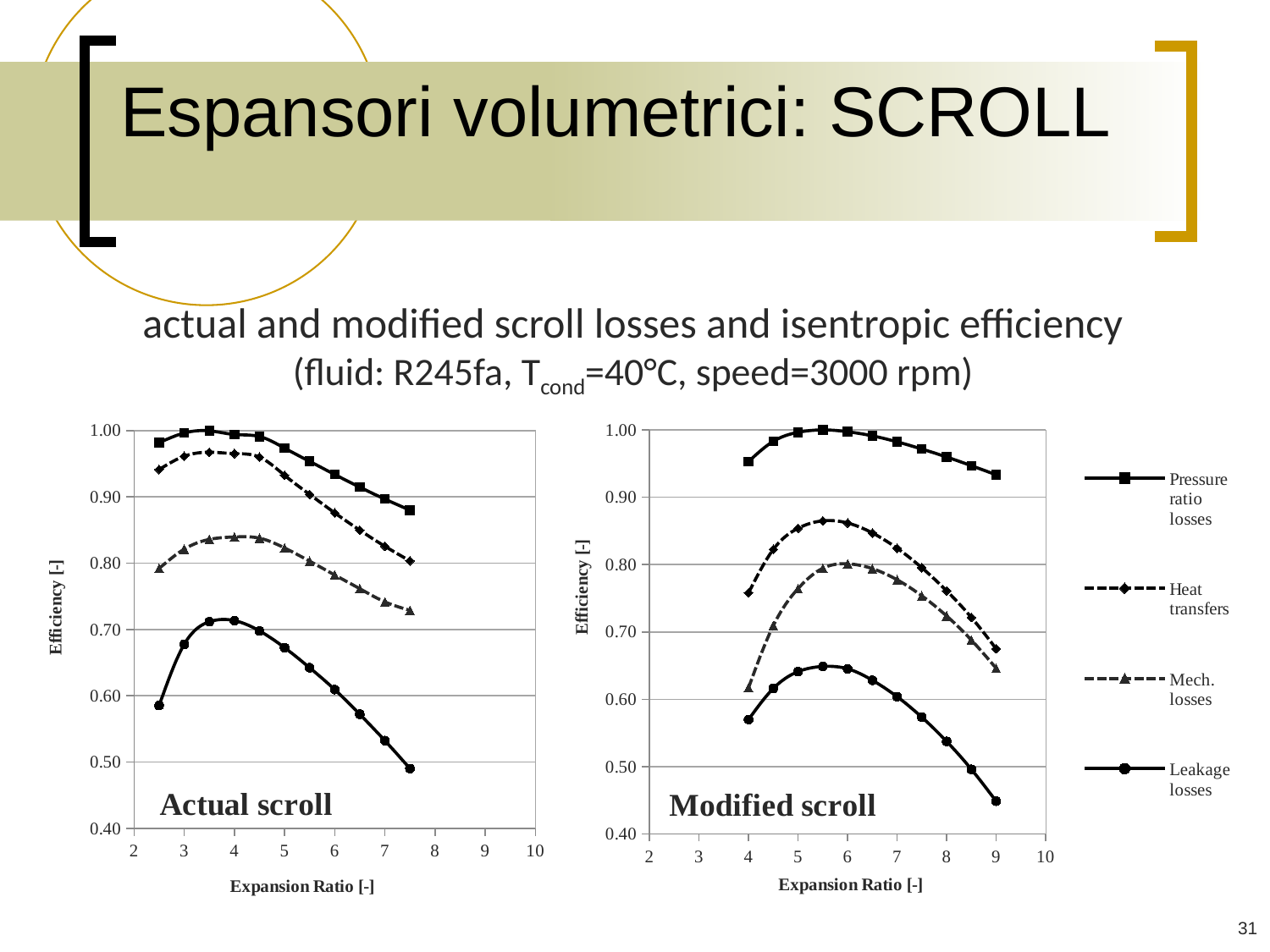
In the 'Modified scroll' chart, is the Pressure ratio losses value at expansion ratio 4 greater or less than 0.90? greater In the 'Actual scroll' chart, is the Leakage losses value at expansion ratio 2.5 greater or less than 0.50? greater How many series does the legend list for the charts? 4 In the 'Actual scroll' chart, at expansion ratio 5, which series has the higher value: Heat transfers or Mech. losses? Heat transfers In the 'Actual scroll' chart, does the Pressure ratio losses series rise or fall as the expansion ratio increases from 5 to 7.5? fall In the 'Modified scroll' chart, is the Leakage losses value at expansion ratio 9 greater or less than 0.50? less What kind of chart is the 'Actual scroll' chart on the left? line chart In the 'Modified scroll' chart, which series has the lowest efficiency values across the expansion ratio range? Leakage losses What is the x-axis title of the 'Modified scroll' chart? Expansion Ratio [-] In the 'Modified scroll' chart, does the Leakage losses series rise or fall as the expansion ratio increases from 4 to 5.5? rise In the 'Actual scroll' chart, which series has the highest efficiency values across the expansion ratio range? Pressure ratio losses